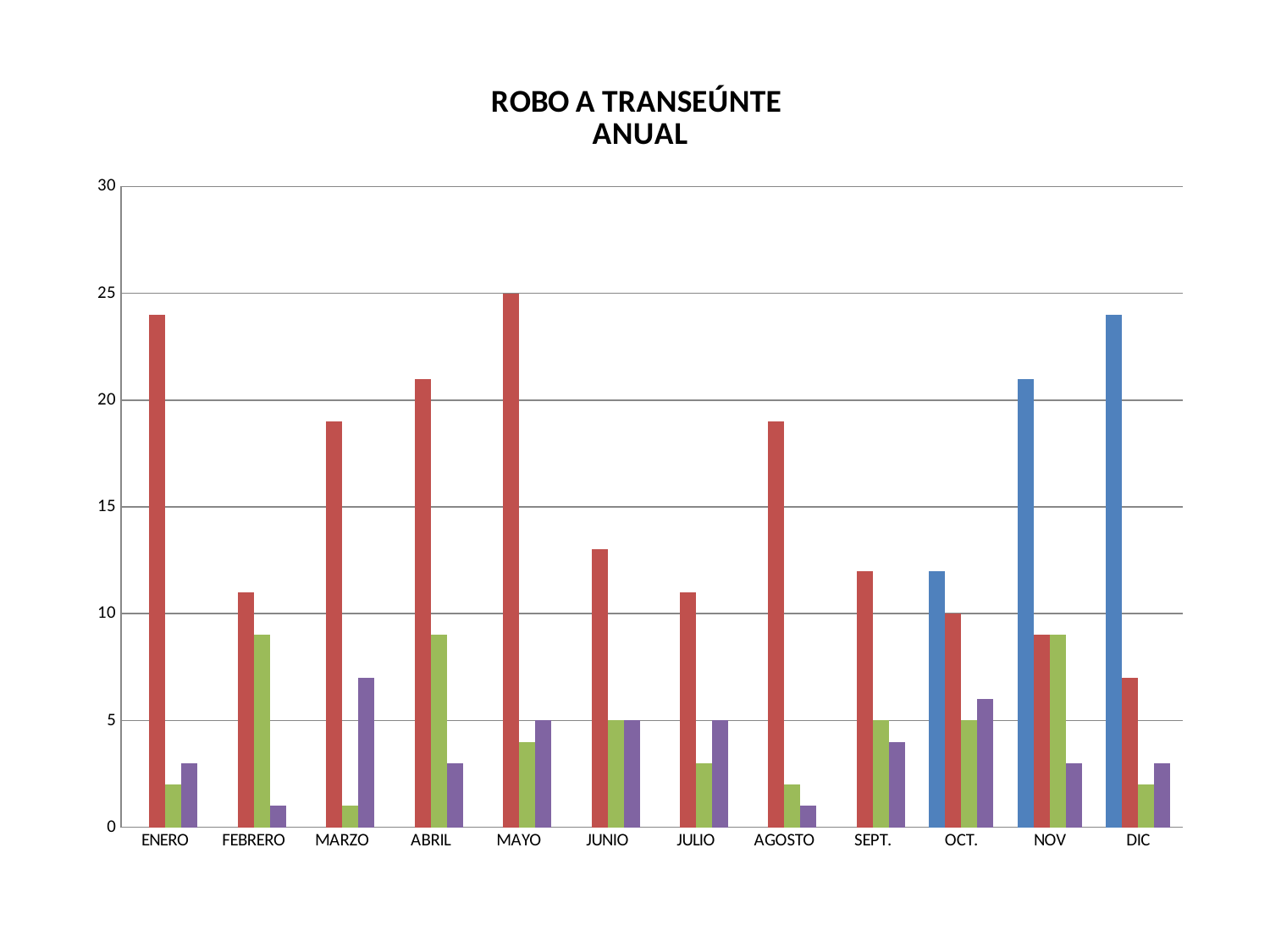
What is the value of the red bar for MAYO? 25 In which month is the blue bar highest? DIC What is the value of the red bar for OCT.? 10 How many months (categories) are shown on the x axis? 12 Is the red bar for ENERO greater or less than 20? greater What is the value of the purple bar for JUNIO? 5 Is the blue bar for NOV greater or less than 20? greater What is the title of the chart? ROBO A TRANSEÚNTE ANUAL Which is larger, the red bar for ABRIL or the red bar for JUNIO? ABRIL What type of chart is shown on the slide? bar chart In which month is the red bar highest? MAYO Is the red bar for FEBRERO greater or less than 15? less